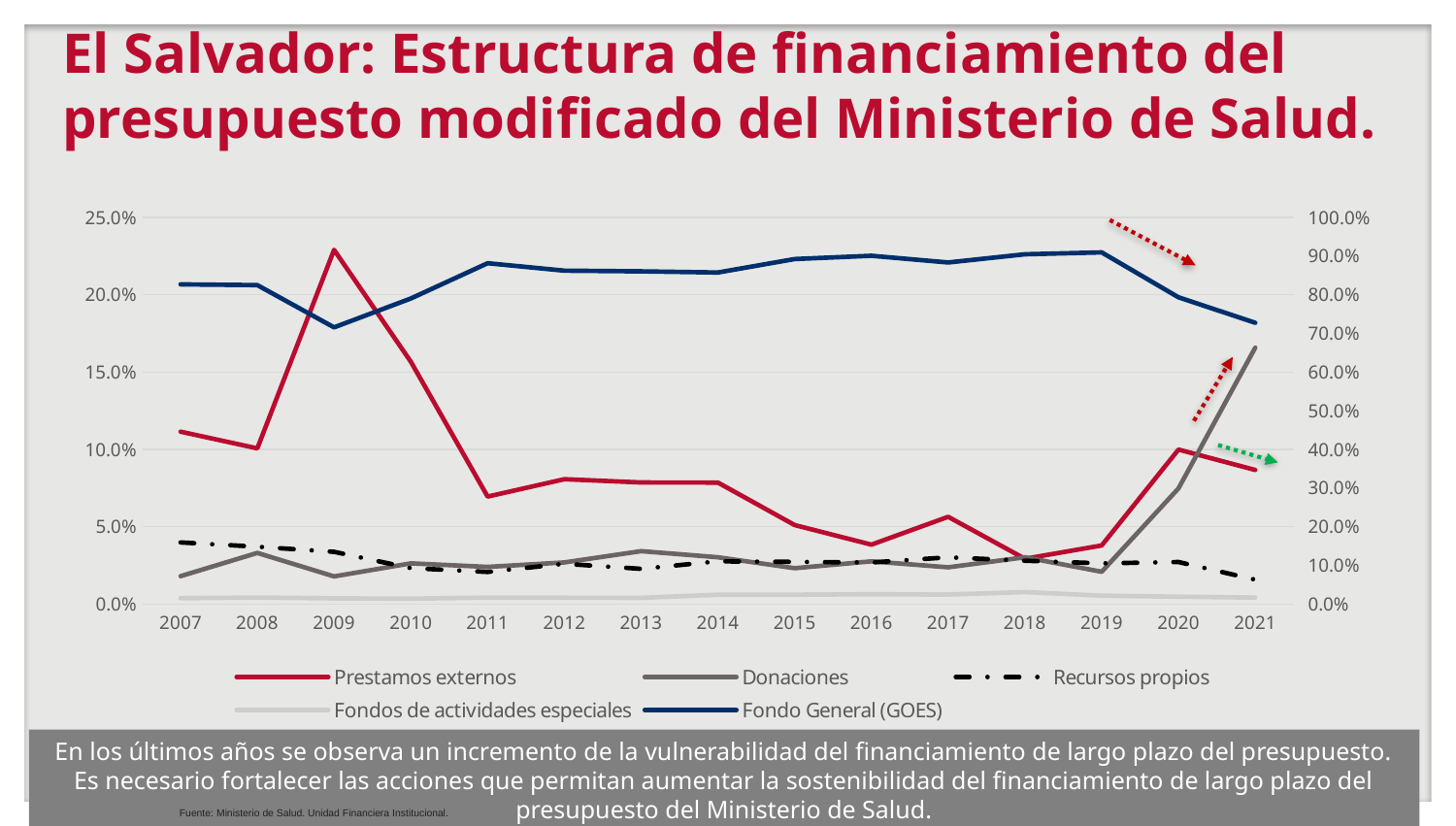
Is the value for Donaciones in 2021 greater or less than 15.0% on the left axis? greater How many series does the legend list? 5 Which series is drawn with a dashed black line? Recursos propios What kind of chart is shown on the slide? Line chart In which year does the Donaciones line reach its highest value? 2021 In which year does the Prestamos externos line reach its highest value? 2009 How many years are plotted along the x axis? 15 Is the value for Fondo General (GOES) in 2021 greater or less than 80.0% on the right axis? less Is the value for Prestamos externos in 2009 greater or less than 20.0% on the left axis? greater In 2021, which is higher: Donaciones or Prestamos externos? Donaciones Does the Fondo General (GOES) line rise or fall from 2019 to 2021? Fall